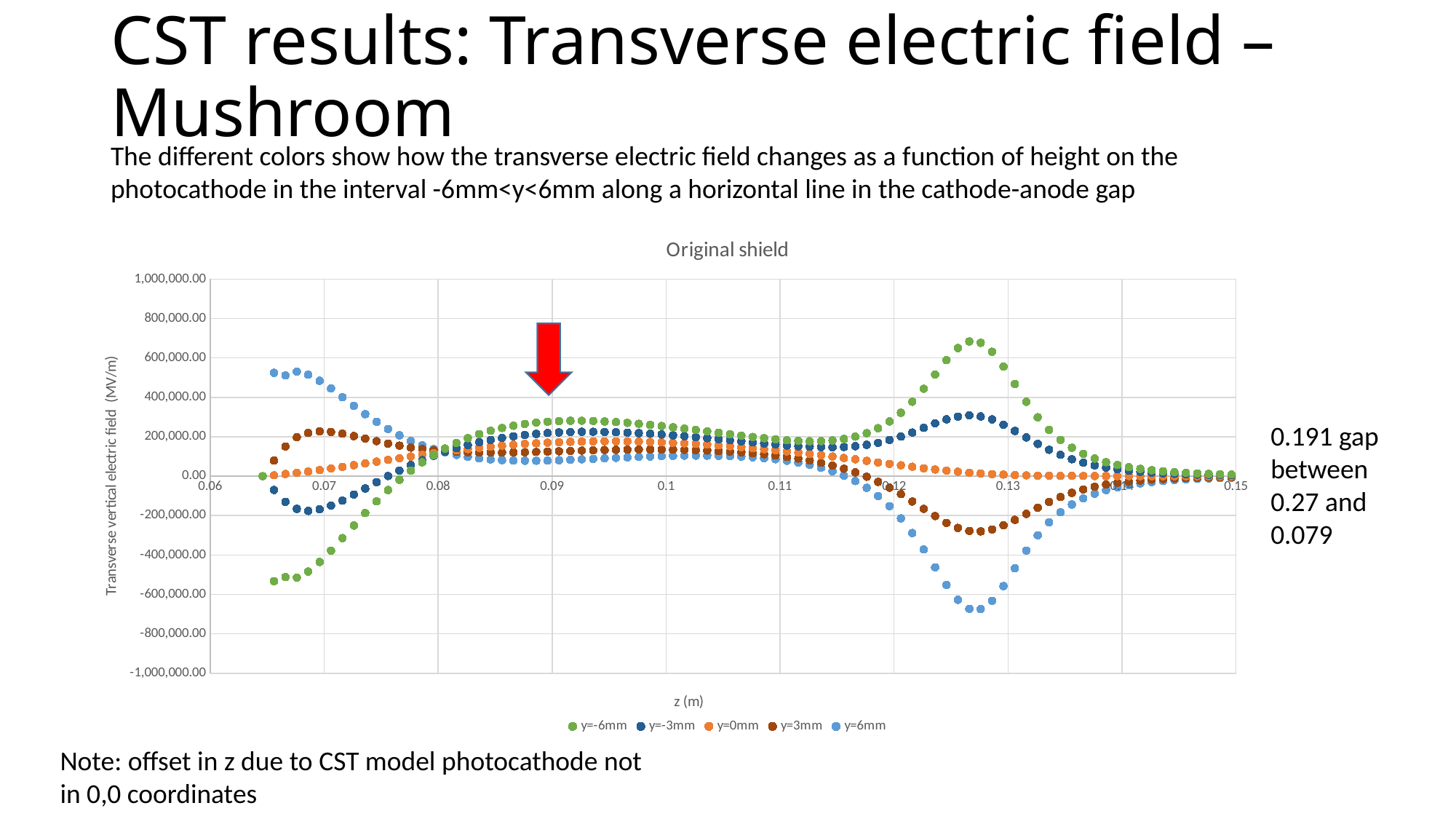
What is the label of the x axis of the chart? z (m) What kind of chart is shown on the slide? scatter chart Is the lowest value of the y=3mm series near z=0.13 greater or less than -200,000.00? less At z=0.065, which series has the larger value, y=6mm or y=-6mm? y=6mm Does the y=-6mm series rise or fall between z=0.13 and z=0.15? fall What is the title of the chart? Original shield Is the peak value of the y=-3mm series near z=0.13 greater or less than 200,000.00? greater Is the lowest value of the y=6mm series near z=0.13 greater or less than -600,000.00? less How many series does the chart legend list? 5 Which series has the lowest value at z=0.09? y=6mm Which series has the highest value at z=0.09? y=-6mm